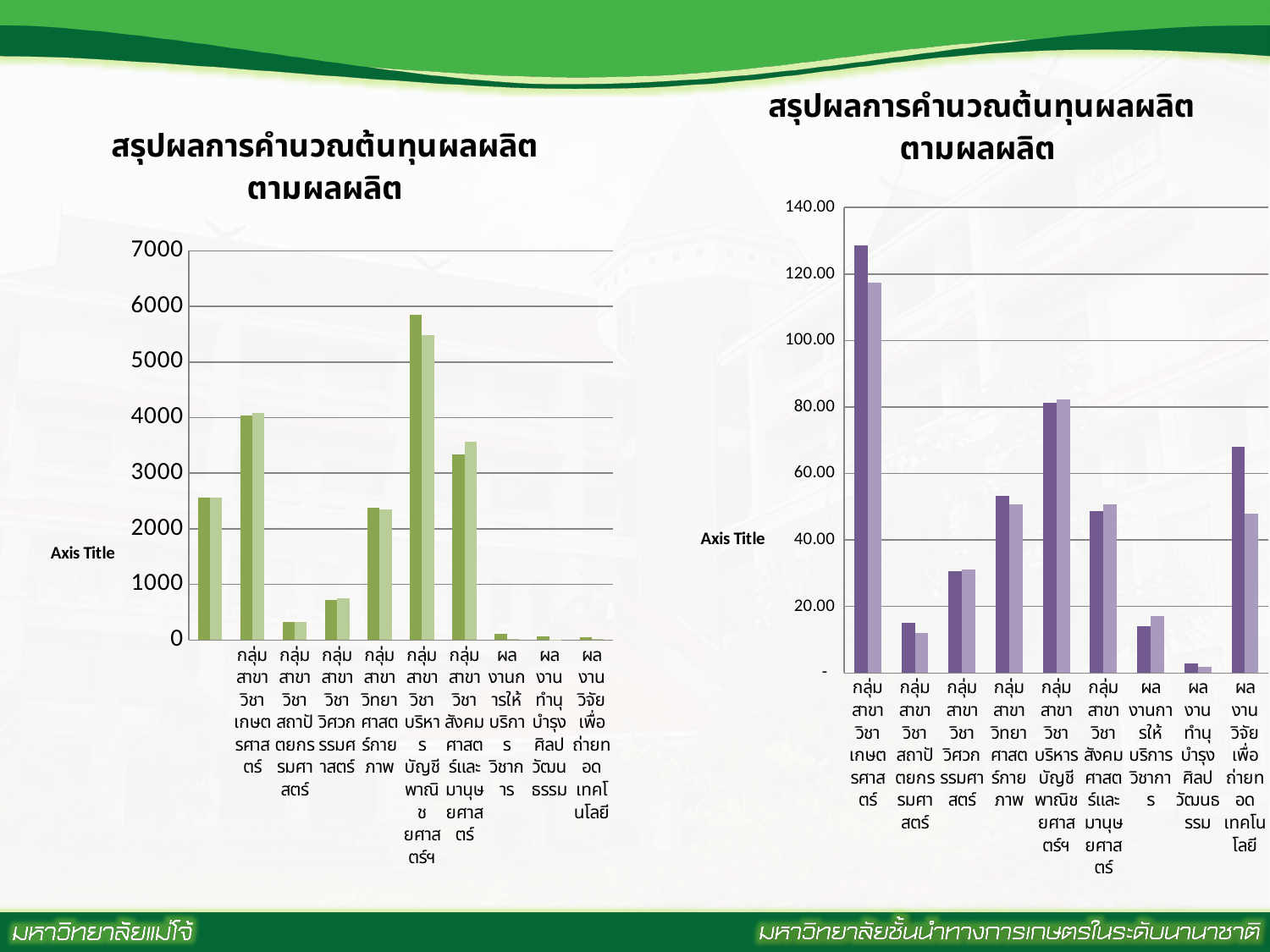
In the left chart, which category has the highest bar? กลุ่มสาขาวิชาบริหาร บัญชี พาณิชยศาสตร์ฯ In the right chart, is the first bar for ผลงานวิจัยเพื่อถ่ายทอดเทคโนโลยี greater or less than 60.00? greater In the left chart, is the first bar for กลุ่มสาขาวิชาสังคมศาสตร์และมานุษยศาสตร์ greater or less than 5000? less What is the y-axis title shown on the right chart? Axis Title In the right chart, is the first bar for กลุ่มสาขาวิชาเกษตรศาสตร์ greater or less than 120.00? greater In the left chart, which has taller bars: กลุ่มสาขาวิชาสถาปัตยกรรมศาสตร์ or กลุ่มสาขาวิชาบริหารบัญชีพาณิชยศาสตร์ฯ? กลุ่มสาขาวิชาบริหาร บัญชี พาณิชยศาสตร์ฯ In the right chart, which category has the lowest bars? ผลงานทำนุบำรุงศิลปวัฒนธรรม What kind of chart is the left chart on the slide? bar chart How many categories are shown on the x axis of the right chart? 9 In the right chart, which category has the highest bar? กลุ่มสาขาวิชาเกษตรศาสตร์ In the right chart, which has taller bars: กลุ่มสาขาวิชาวิทยาศาสตร์กายภาพ or กลุ่มสาขาวิชาวิศวกรรมศาสตร์? กลุ่มสาขาวิชาวิทยาศาสตร์กายภาพ